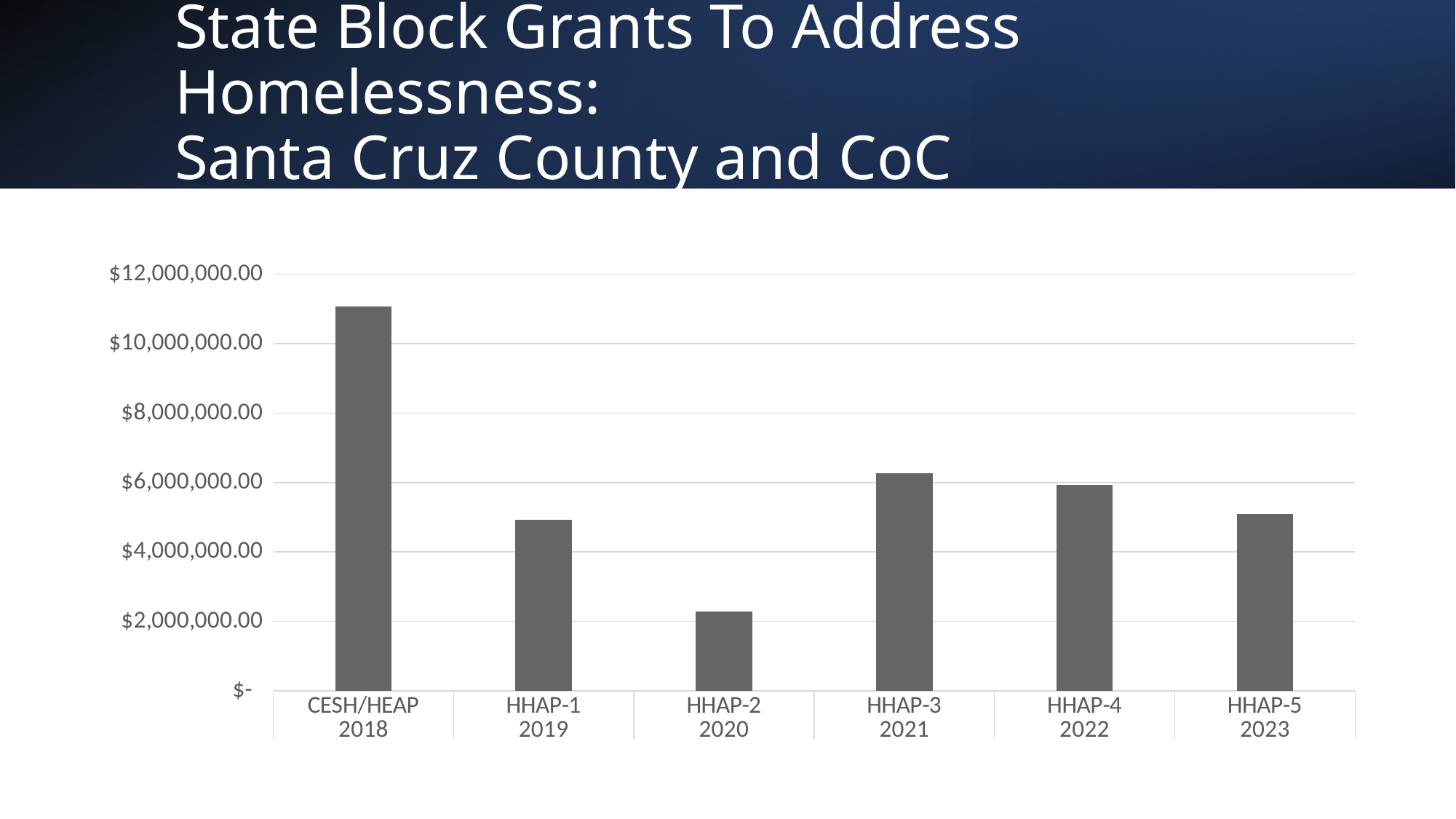
Do the values rise or fall from HHAP-3 2021 to HHAP-5 2023? fall Is the value for HHAP-1 2019 greater or less than $6,000,000.00? less Which category has the lowest value? HHAP-2 2020 Which is larger, the value for HHAP-3 2021 or the value for HHAP-1 2019? HHAP-3 2021 Is the value for HHAP-3 2021 greater or less than $6,000,000.00? greater What is the title of the slide containing the chart? State Block Grants To Address Homelessness: Santa Cruz County and CoC Which is larger, the value for HHAP-2 2020 or the value for HHAP-4 2022? HHAP-4 2022 How many bars (categories) are plotted in the chart? 6 Which category has the highest value? CESH/HEAP 2018 What kind of chart is shown on the slide? bar chart Is the value for CESH/HEAP 2018 greater or less than $10,000,000.00? greater